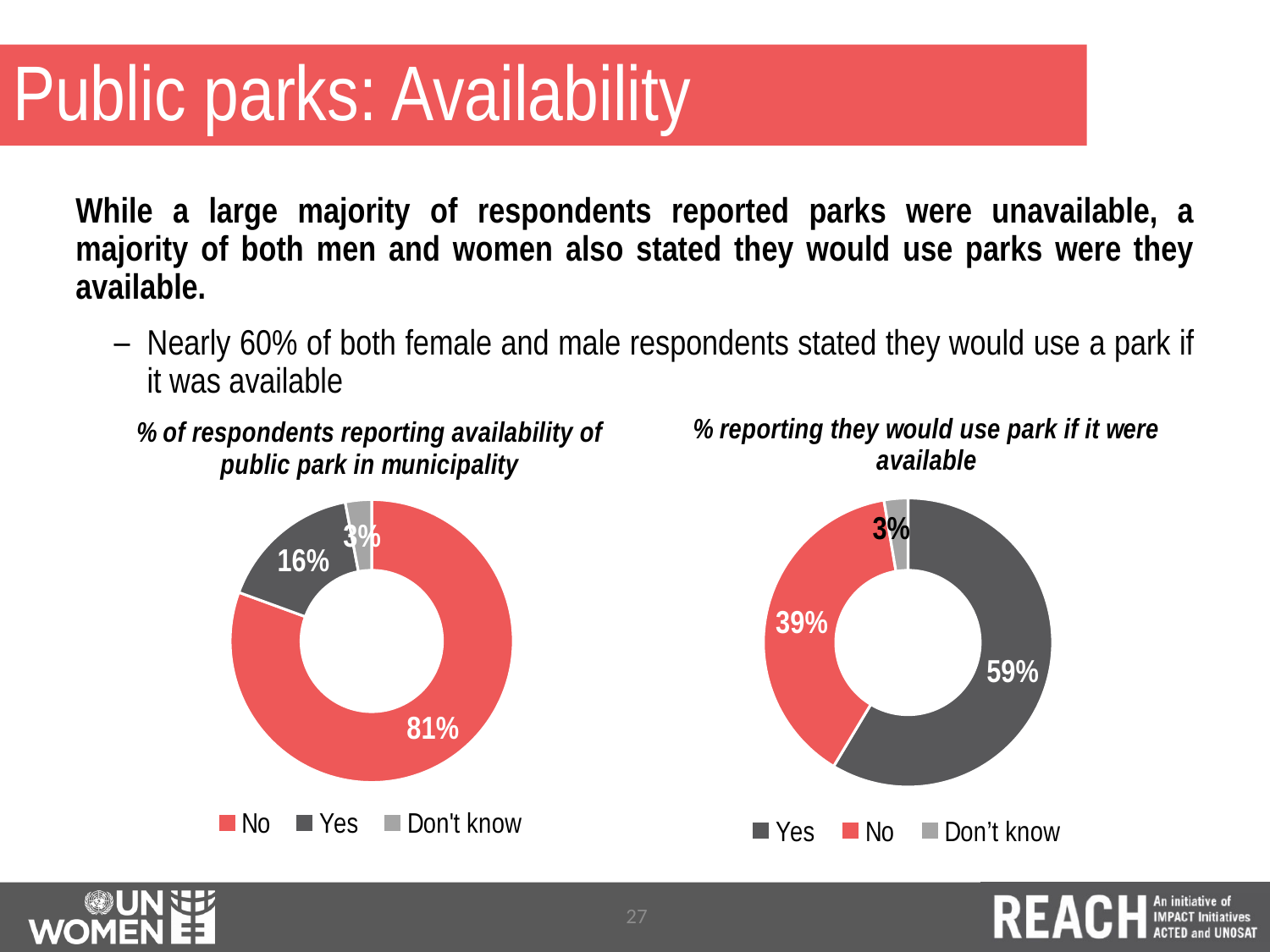
In the chart titled '% reporting they would use park if it were available', what percentage of respondents answered 'Yes'? 59% In the chart titled '% reporting they would use park if it were available', what percentage of respondents answered 'Don't know'? 3% In the right chart, which response category has the smallest share? Don't know In the chart titled '% of respondents reporting availability of public park in municipality', what percentage of respondents answered 'Yes'? 16% In the right chart, which is larger: the share for 'Yes' or the share for 'No'? Yes What type of chart is used on the right side of the slide? Doughnut chart In the chart titled '% reporting they would use park if it were available', what percentage of respondents answered 'No'? 39% How many categories does the legend of the left chart list? 3 In the right chart, what is the difference in percentage points between the 'Yes' and 'No' shares? 20 In the chart titled '% of respondents reporting availability of public park in municipality', what percentage of respondents answered 'No'? 81% In the left chart, what is the difference in percentage points between the 'No' and 'Yes' shares? 65 In the left chart, which response category has the largest share? No